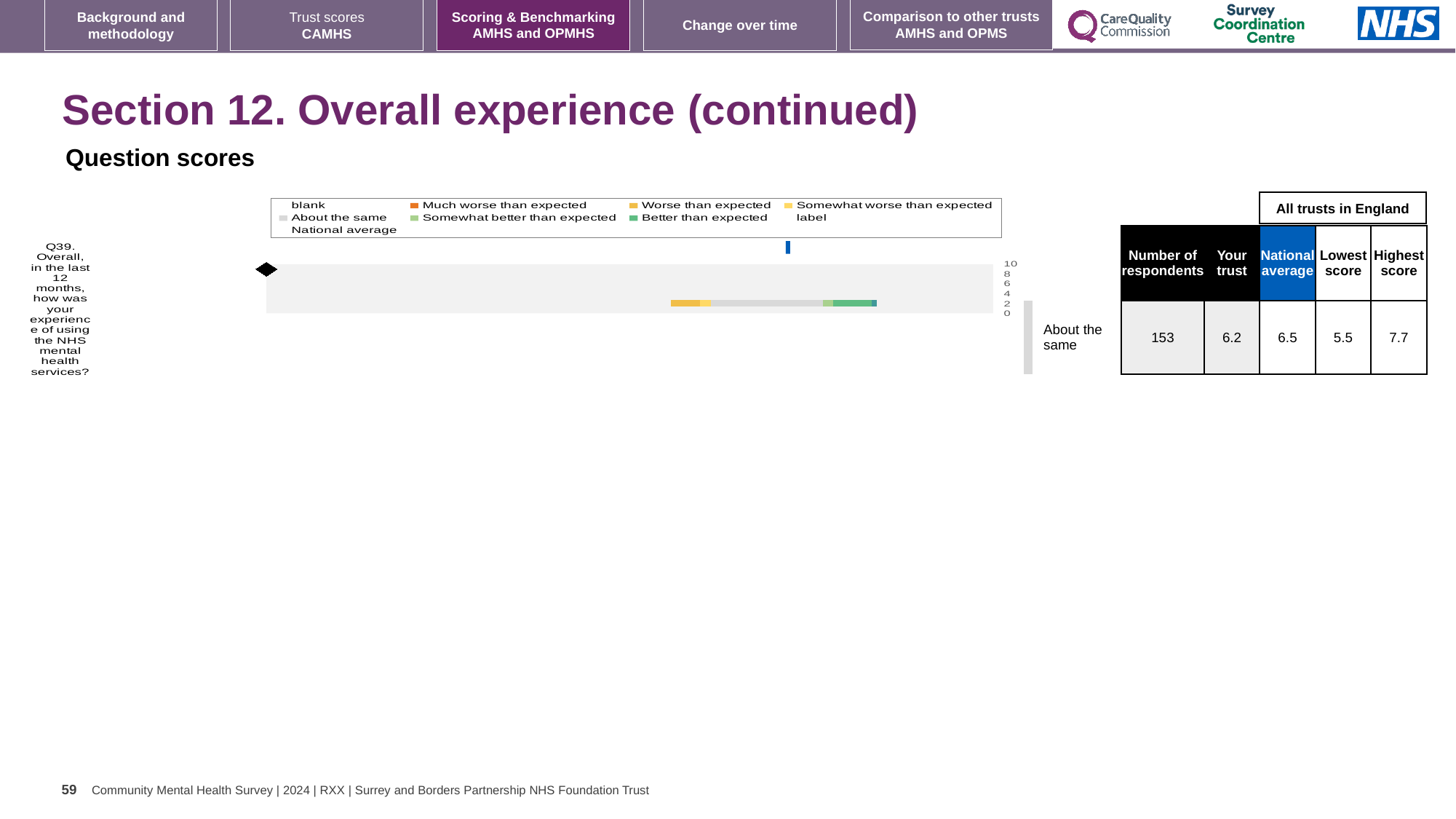
For Q39, what is the difference between the highest score and the lowest score among all trusts in England? 2.2 In the table beside the chart, what is the lowest score among all trusts in England for Q39? 5.5 What benchmark category label is shown next to the Q39 bar? About the same In the table beside the chart, what is the 'Your trust' score for Q39? 6.2 In the table beside the chart, what is the highest score among all trusts in England for Q39? 7.7 For Q39, which is larger: the 'Your trust' score or the national average? National average Which question number is plotted in the question scores chart? Q39 How many survey questions are plotted in the question scores chart? 1 In the table beside the chart, what is the national average score for Q39? 6.5 What kind of chart is used to show the Q39 question score? bar chart In the table beside the chart, how many respondents answered Q39? 153 For Q39, what is the difference between the national average and the 'Your trust' score? 0.3